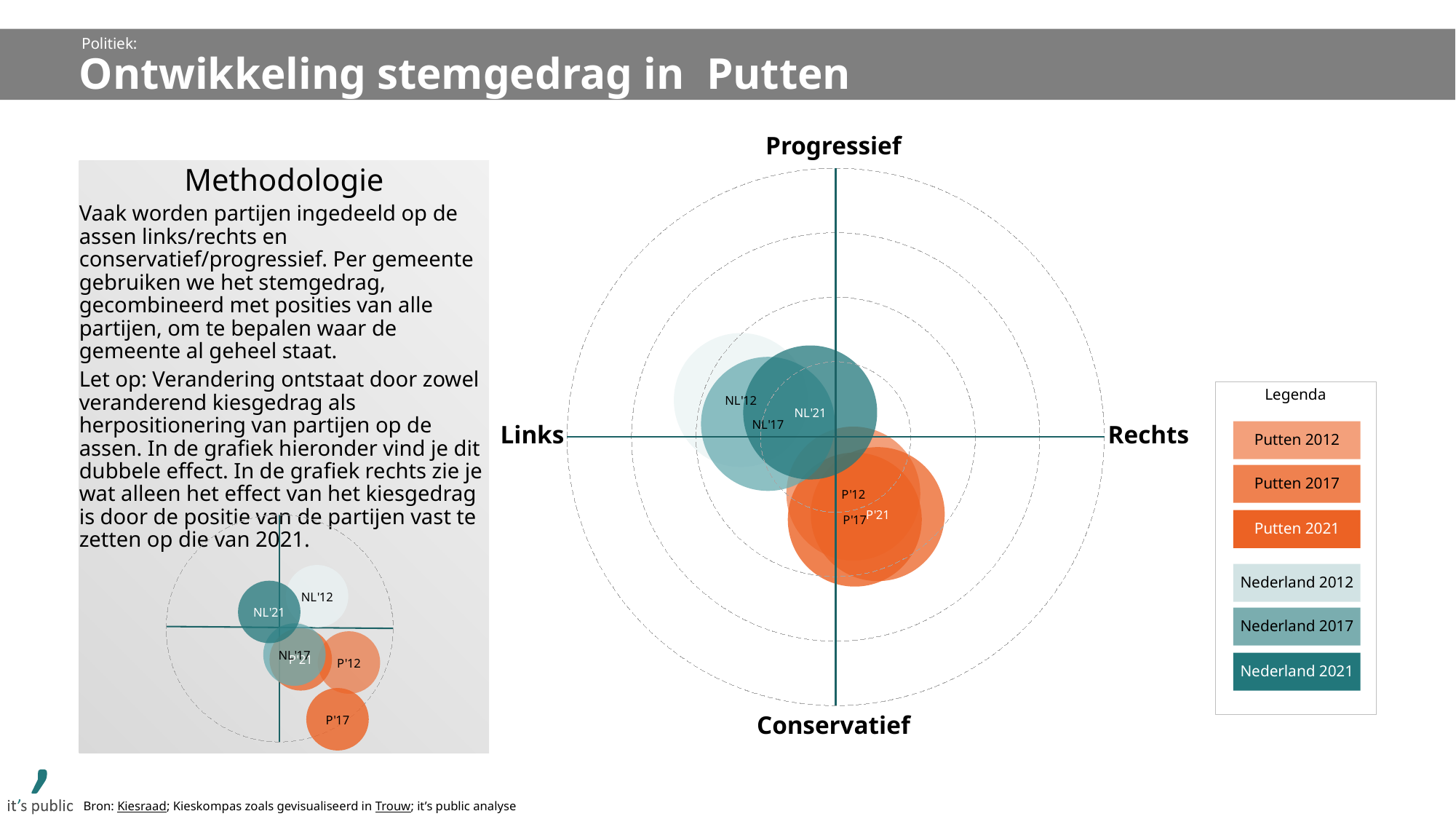
In the small chart inside the Methodologie box, which bubble lies further towards Progressief: NL'12 or P'21? NL'12 In the large chart on the right, which bubble lies further towards Progressief: NL'12 or P'17? NL'12 In the large chart on the right, which bubble lies further to the right (Rechts): P'21 or NL'21? P'21 In the large chart on the right, in which quadrant are all the Putten bubbles (P'12, P'17, P'21) located? Rechts / Conservatief (lower right) What label appears at the top end of the vertical axis of the large chart? Progressief How many entries does the legend (Legenda) list? 6 In the small chart inside the Methodologie box, which bubble is positioned lowest (most Conservatief)? P'17 How many labelled bubbles are plotted in the large chart on the right? 6 What kind of chart is the large chart on the right of the slide? Bubble chart In the small chart inside the Methodologie box, which bubble is positioned furthest to the right? P'12 In the large chart on the right, in which quadrant are the Nederland bubbles (NL'12, NL'17, NL'21) mainly located? Links / Progressief (upper left) Which three years are listed for Putten in the legend? 2012, 2017, 2021